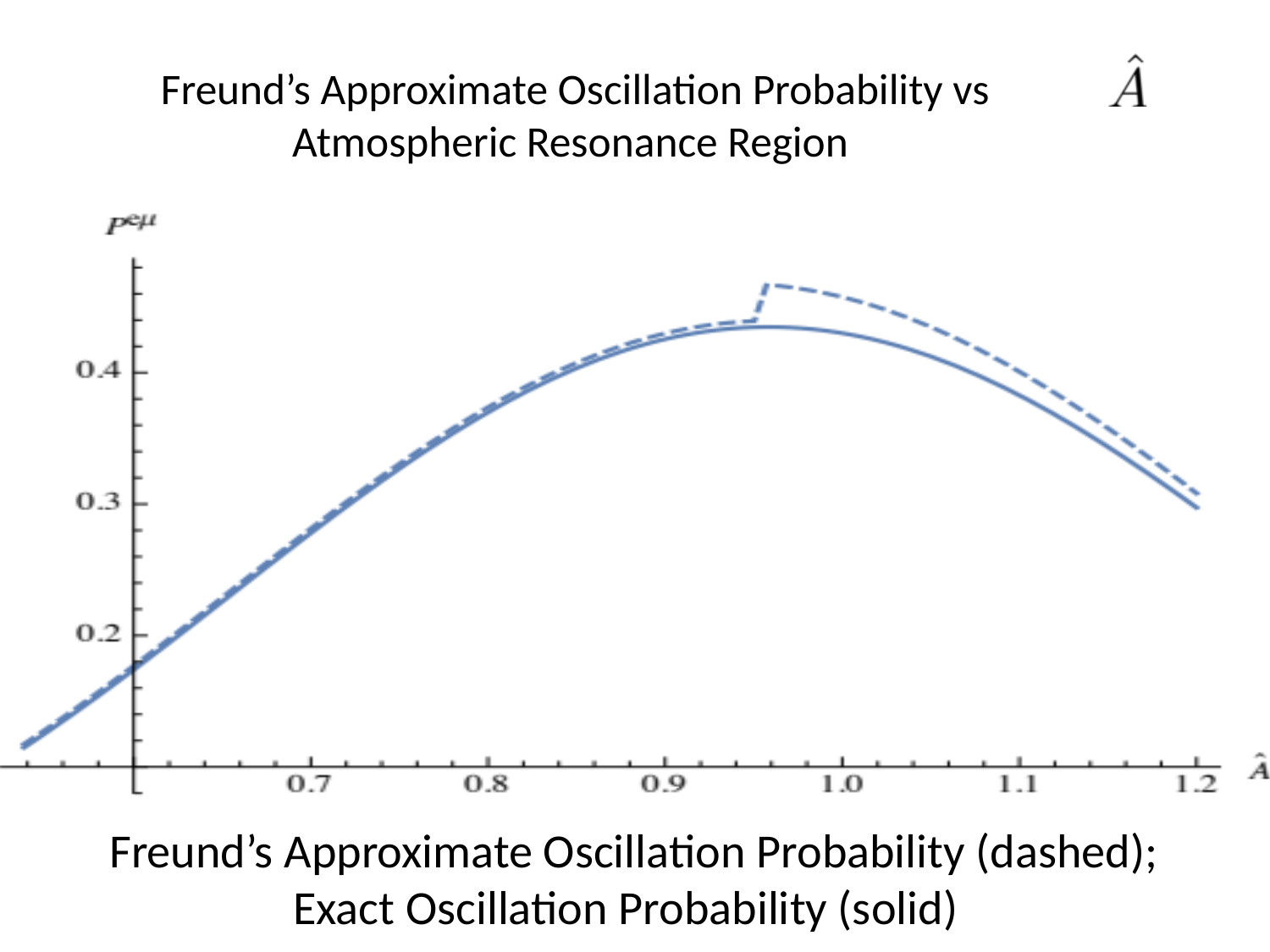
At Â = 1.1, which curve has the higher value, the dashed or the solid one? dashed Does the solid curve rise or fall as Â increases from 0.7 to 0.9? rise Is the peak value of the solid curve greater or less than 0.4? greater Is the value of the solid curve at Â = 1.0 greater or less than 0.4? greater How many curves are plotted on the chart? 2 Is the value of the solid curve at Â = 0.7 greater or less than 0.3? less What is the label on the horizontal axis of the chart? Â Which curve represents Freund's Approximate Oscillation Probability, the dashed or the solid one? dashed At Â = 1.0, which curve has the higher value, the dashed or the solid one? dashed What kind of chart is shown on the slide? line chart